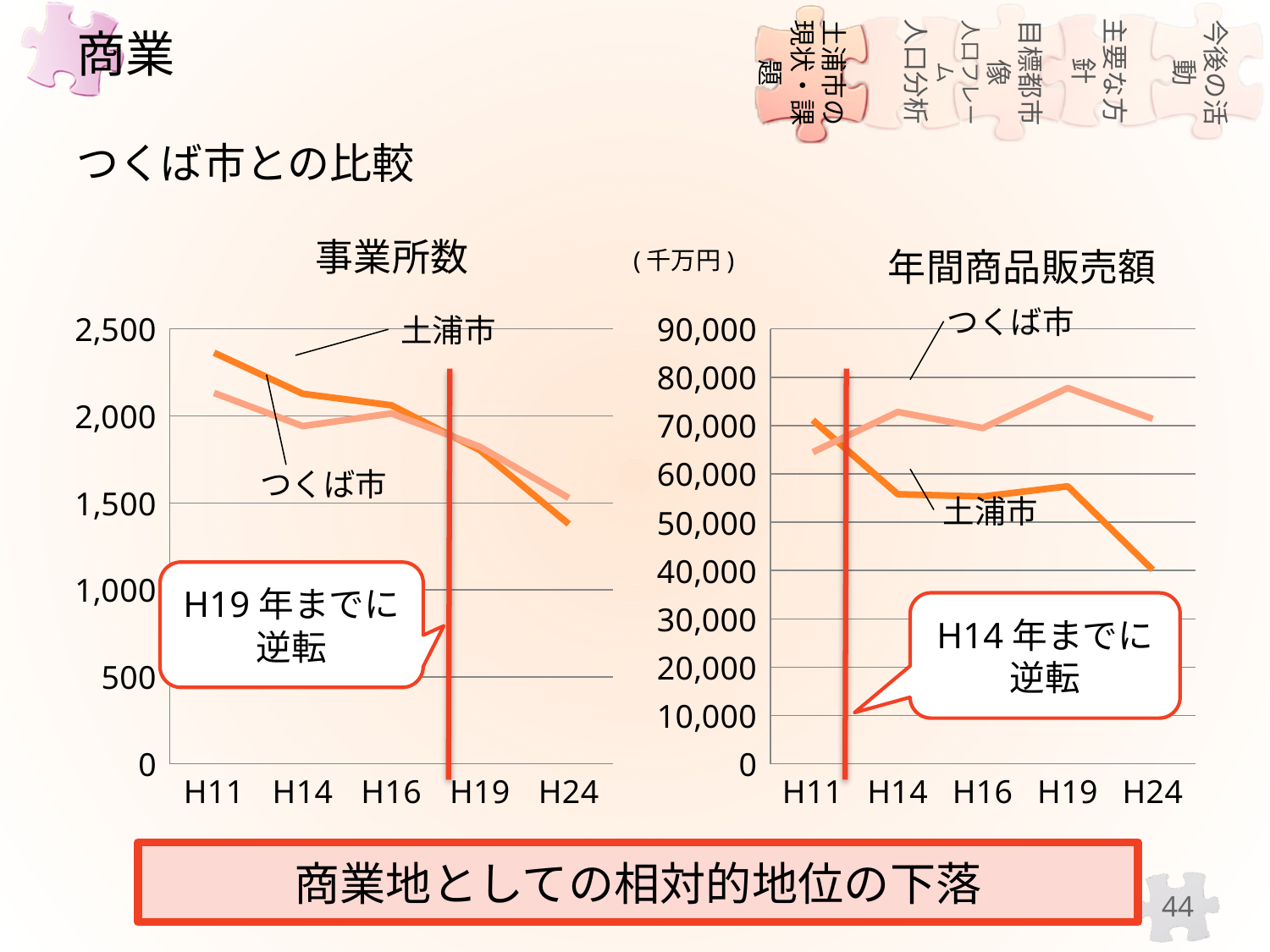
In the 事業所数 chart, which is higher at H11, 土浦市 or つくば市? 土浦市 In the 事業所数 chart, is the value for 土浦市 at H24 greater or less than 1,500? less In the 年間商品販売額 chart, is the value for つくば市 at H19 greater or less than 70,000? greater In the 年間商品販売額 chart, is the value for 土浦市 at H24 greater or less than 50,000? less In the 事業所数 chart, which is higher at H24, 土浦市 or つくば市? つくば市 How many series are plotted in the 事業所数 chart? 2 What kind of chart is the 事業所数 chart? line chart In the 年間商品販売額 chart, which is higher at H24, 土浦市 or つくば市? つくば市 In the 事業所数 chart, does the 土浦市 line rise or fall from H11 to H24? fall What unit is shown for the 年間商品販売額 chart? 千万円 How many points are on the x axis of the 年間商品販売額 chart? 5